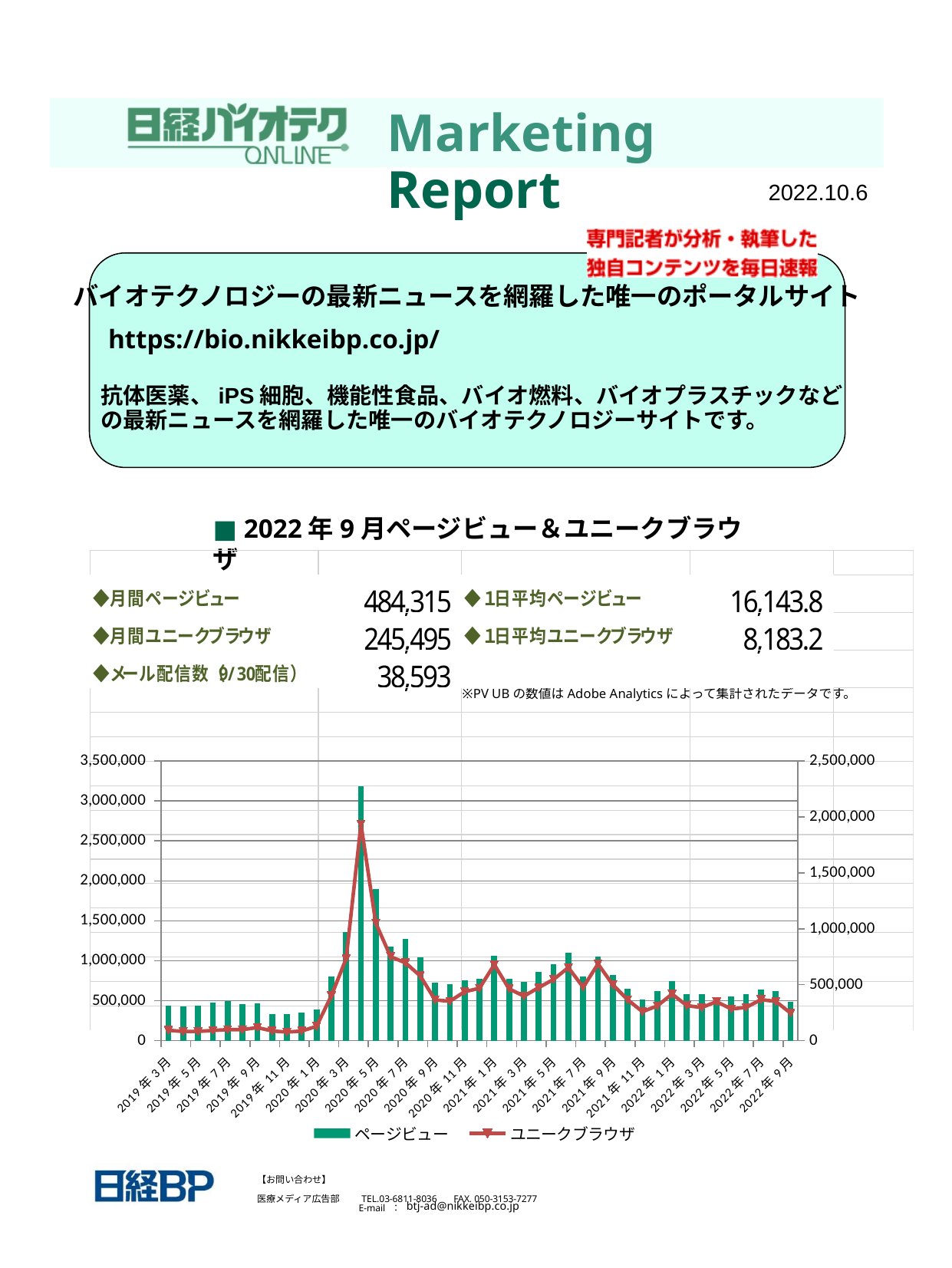
Is the peak value of the ユニークブラウザ line greater or less than 1,500,000 on the right axis? greater How many series does the chart legend list? 2 Do the ページビュー values rise or fall from 2020年1月 to 2020年3月? rise Which has the larger ページビュー value, 2020年5月 or 2019年5月? 2020年5月 Is the highest ページビュー bar greater or less than 3,000,000? greater Which has the larger ページビュー value, 2021年7月 or 2022年7月? 2021年7月 What kind of chart is shown on the slide? Combined bar and line chart Is the ページビュー value for 2020年5月 greater or less than 1,500,000? greater Do the ページビュー values rise or fall from 2020年5月 to 2020年9月? fall Which series is drawn as bars in the chart? ページビュー Which series is drawn as a line in the chart? ユニークブラウザ